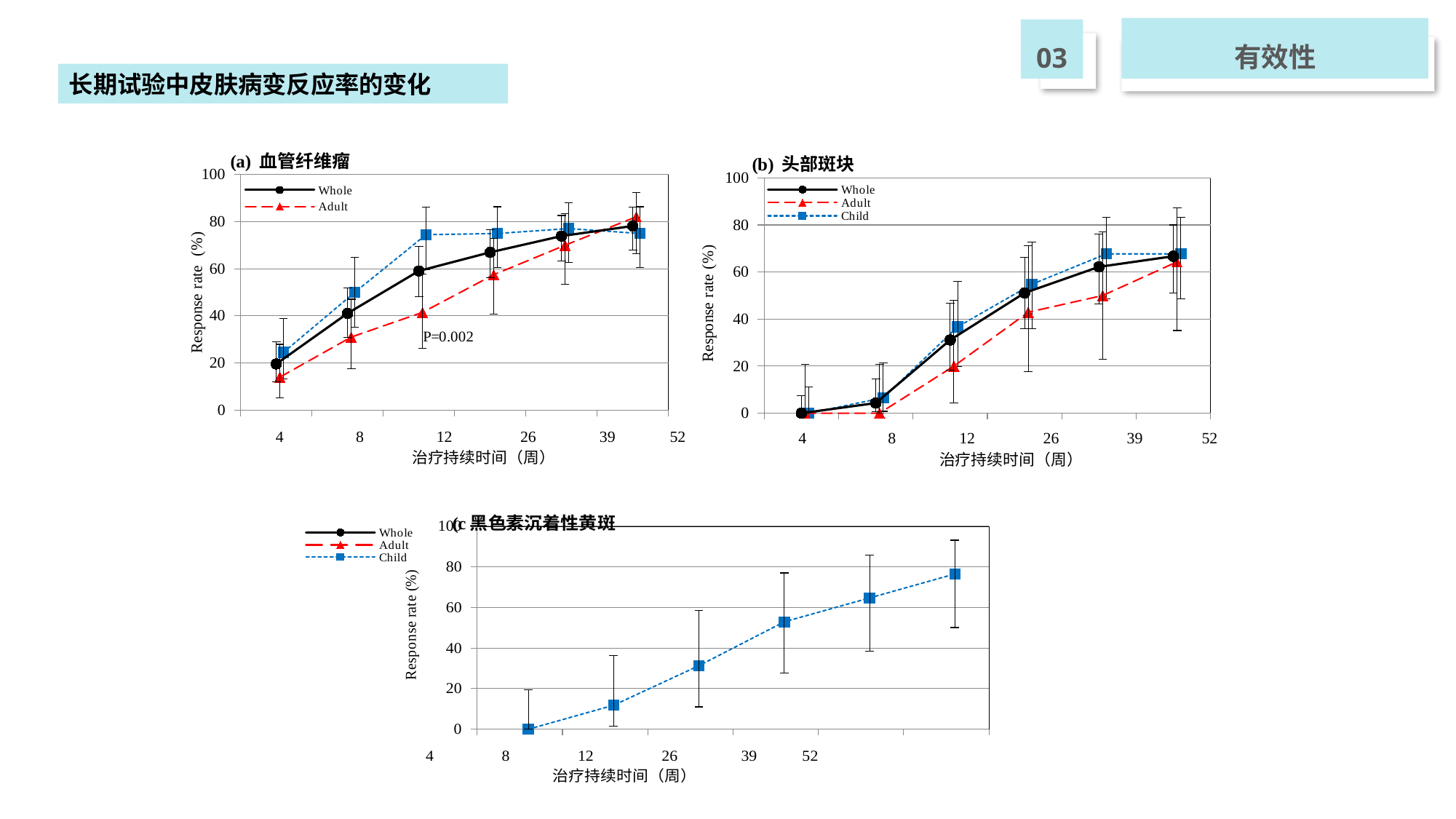
In chart (b) 头部斑块, is the Whole response rate at the last plotted time point greater or less than 40? greater What P value is printed on chart (a) 血管纤维瘤? P=0.002 In chart (c) 黑色素沉着性黄斑, does the response rate rise or fall as treatment duration increases? rises In chart (a) 血管纤维瘤, is the Whole response rate at the first time point (week 4) greater or less than 40? less How many series does the legend of chart (b) 头部斑块 list? 3 In chart (c) 黑色素沉着性黄斑, is the response rate at the last plotted time point greater or less than 60? greater What is the y-axis label of chart (b) 头部斑块? Response rate (%) How many series does the legend of chart (a) 血管纤维瘤 list? 2 What kind of chart is chart (a) 血管纤维瘤? line chart In chart (c) 黑色素沉着性黄斑, how many data points are plotted on the line? 6 In chart (a) 血管纤维瘤, at the third plotted time point, which series has the higher response rate, Child or Adult? Child In chart (b) 头部斑块, does the Whole series rise or fall along the x axis? rises